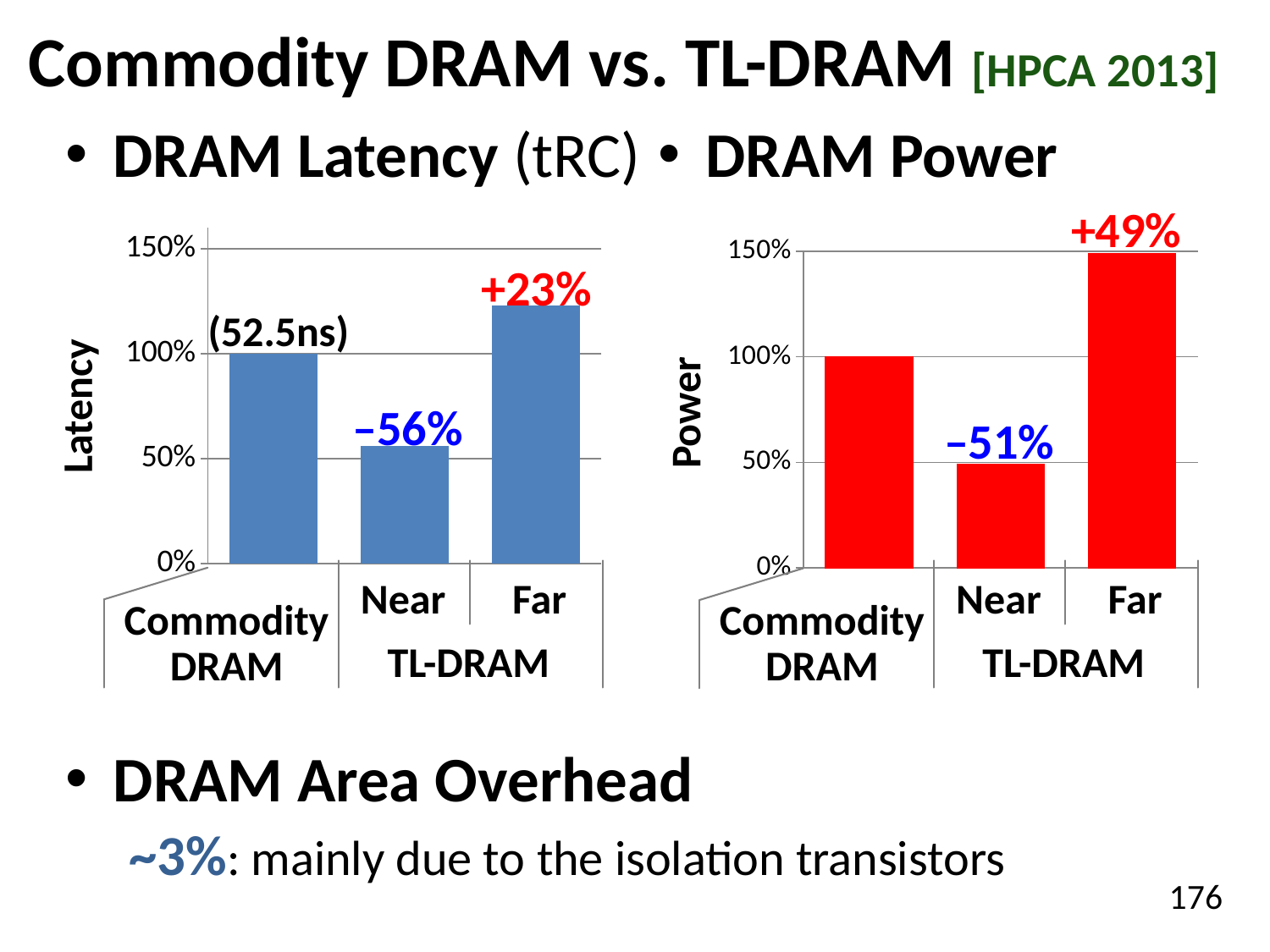
In the DRAM Latency chart, what percentage change is labelled above the Far bar? +23% In the DRAM Power chart, is the value for Far greater or less than 100%? greater In the DRAM Latency chart, is the value for Near greater or less than 50%? greater What colour are the bars in the DRAM Power chart? red In the DRAM Latency chart, what percentage change is labelled above the Near bar? –56% What kind of chart is the DRAM Latency chart on the left? bar chart In the DRAM Latency chart, which bar is the lowest? Near In the DRAM Power chart, which bar is the highest? Far In the DRAM Latency chart, how many bars are plotted? 3 In the DRAM Power chart, what percentage change is labelled above the Near bar? –51% In the DRAM Latency chart, what absolute latency is noted for Commodity DRAM? 52.5ns In the DRAM Power chart, what percentage change is labelled above the Far bar? +49%